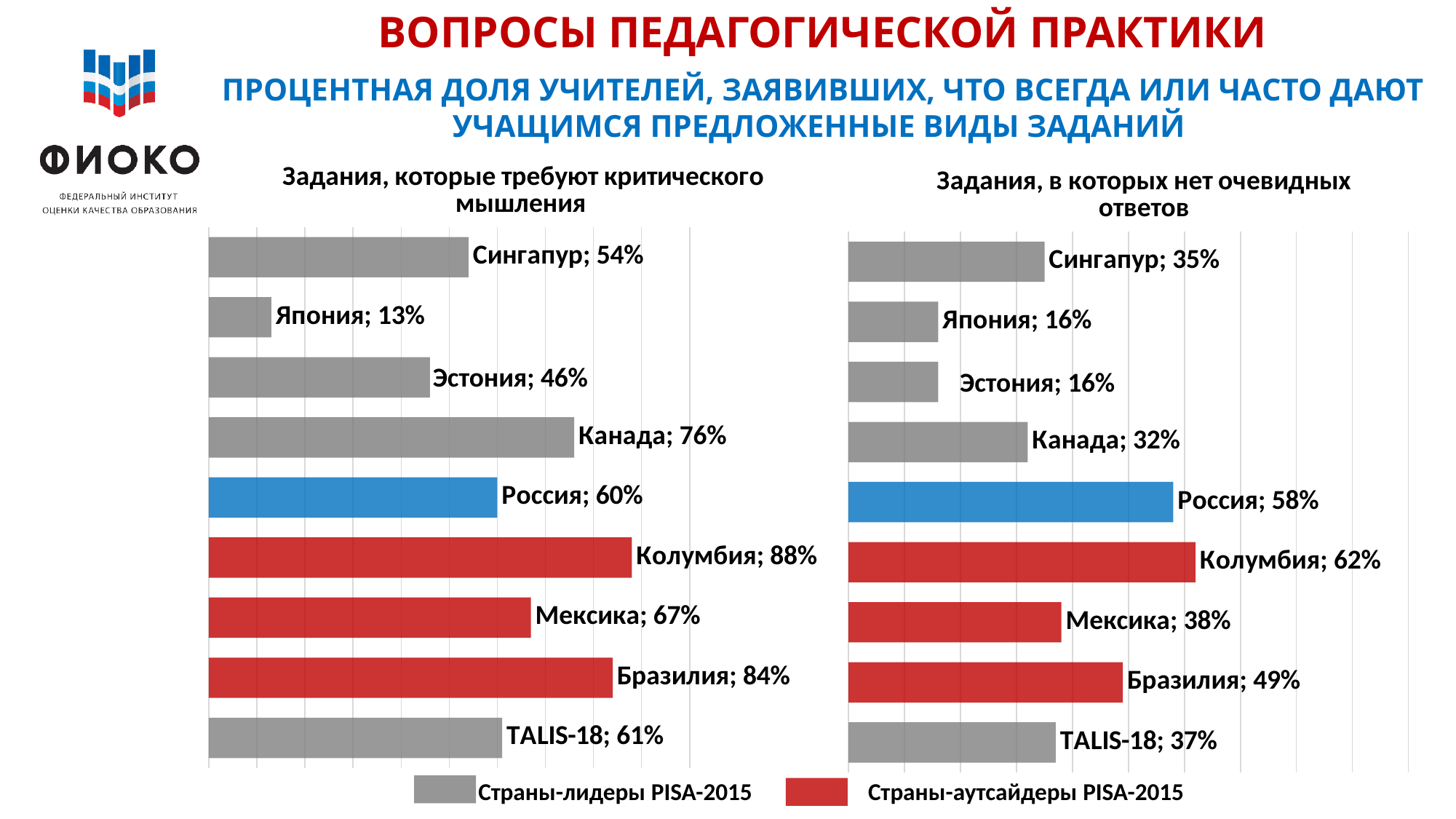
In the chart 'Задания, которые требуют критического мышления', what is the difference between the values for Бразилия and Мексика? 17% In the chart 'Задания, в которых нет очевидных ответов', which is larger: the value for Сингапур or the value for Мексика? Мексика How many categories are shown in the chart 'Задания, в которых нет очевидных ответов'? 9 In the chart 'Задания, которые требуют критического мышления', what is the value for Россия? 60% How many entries does the legend at the bottom of the slide list? 2 In the chart 'Задания, которые требуют критического мышления', which is larger: the value for Канада or the value for Россия? Канада In the chart 'Задания, в которых нет очевидных ответов', what is the value for Канада? 32% In the chart 'Задания, в которых нет очевидных ответов', what is the difference between the values for Россия and TALIS-18? 21% What type of chart is 'Задания, которые требуют критического мышления'? Bar chart In the chart 'Задания, которые требуют критического мышления', which category has the highest value? Колумбия In the chart 'Задания, в которых нет очевидных ответов', which category has the highest value? Колумбия In the chart 'Задания, которые требуют критического мышления', which category has the lowest value? Япония